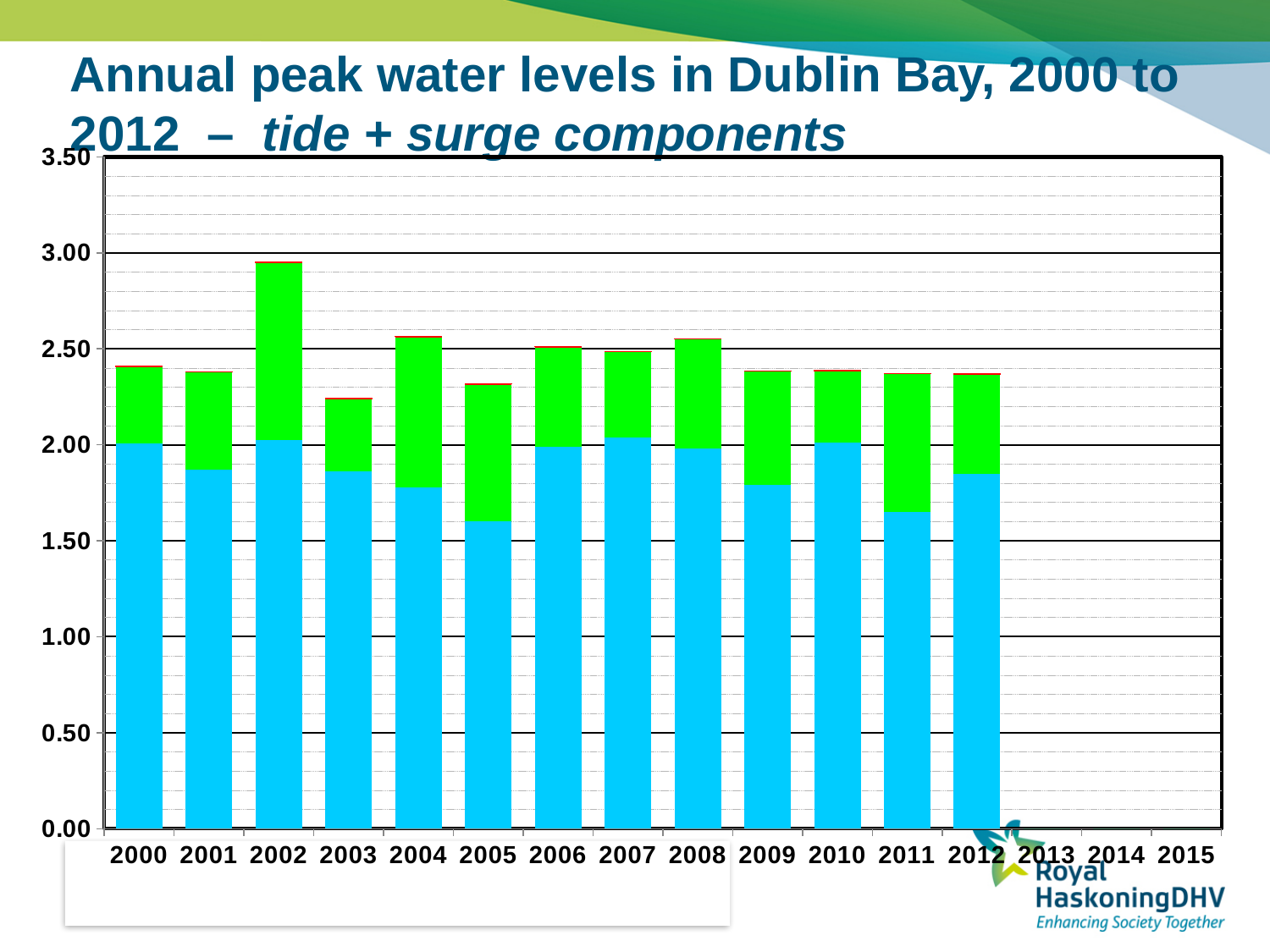
Is the total bar for 2002 greater or less than 2.50? greater What is the title of the chart on the slide? Annual peak water levels in Dublin Bay, 2000 to 2012 – tide + surge components What kind of chart is shown on the slide? Stacked bar chart Is the total bar for 2003 greater or less than 2.50? less Which year has the larger total bar, 2002 or 2003? 2002 What is the highest value labelled on the vertical axis? 3.50 Is the blue (lower) segment for 2011 greater or less than 2.00? less Which year has the highest total peak water level? 2002 How many years have bars plotted in the chart? 13 Which year has the larger total bar, 2004 or 2005? 2004